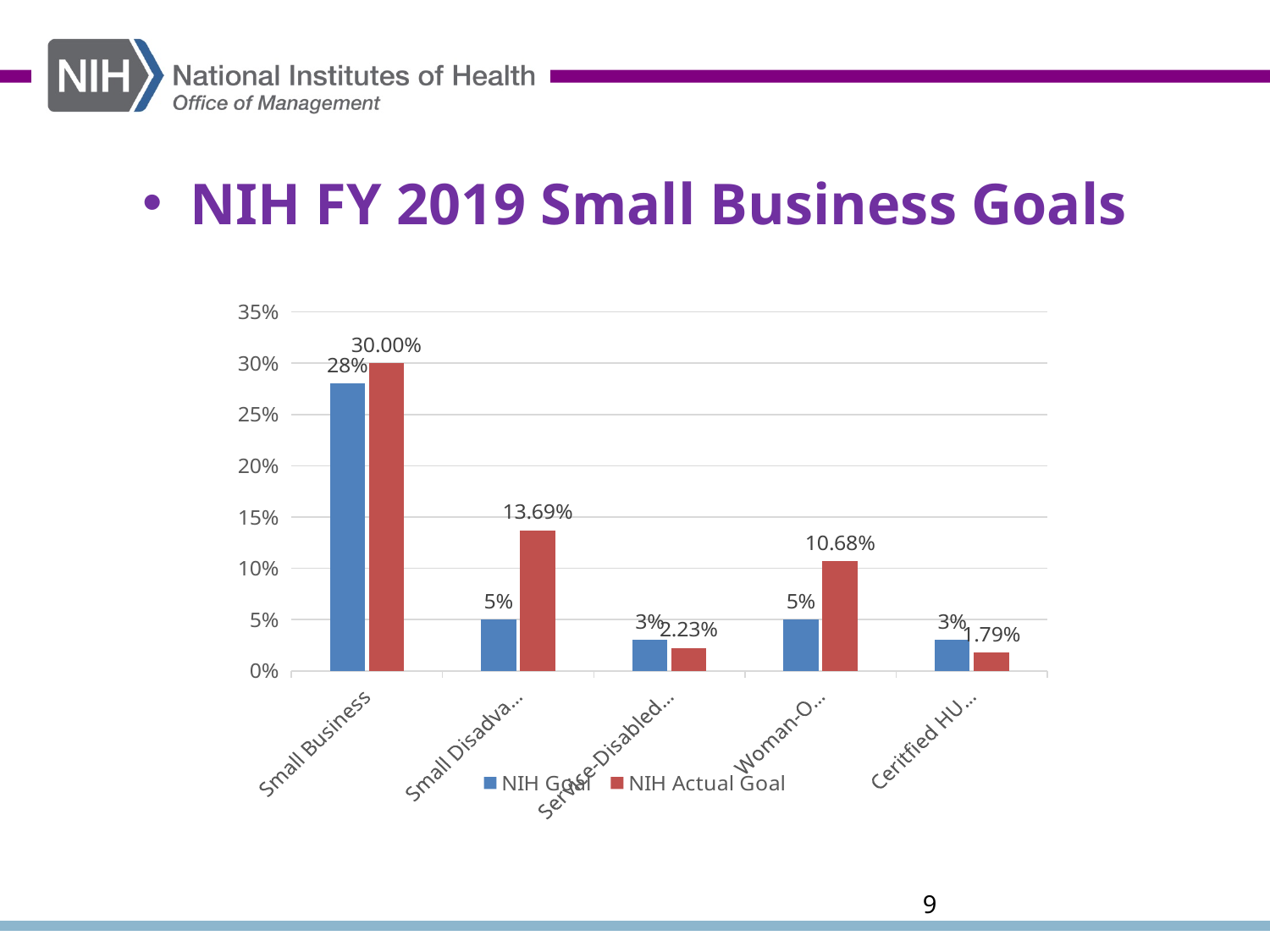
What is the NIH Actual Goal value for the second category (labelled 'Small Disadva…')? 13.69% For the second category (labelled 'Small Disadva…'), which is larger: the NIH Goal or the NIH Actual Goal? NIH Actual Goal What is the lowest NIH Actual Goal value shown on the chart? 1.79% Is the NIH Goal value for Small Business greater or less than 25%? greater What is the NIH Actual Goal value for the fourth category (labelled 'Woman-O…')? 10.68% How many series does the chart's legend list? 2 Which category has the highest NIH Actual Goal value? Small Business What is the NIH Goal value for Small Business? 28% By how much does the NIH Actual Goal for Small Business exceed the NIH Goal for Small Business? 2% What is the NIH Actual Goal value for Small Business? 30.00% What kind of chart is shown on the slide? bar chart How many categories are shown on the x axis of the chart? 5